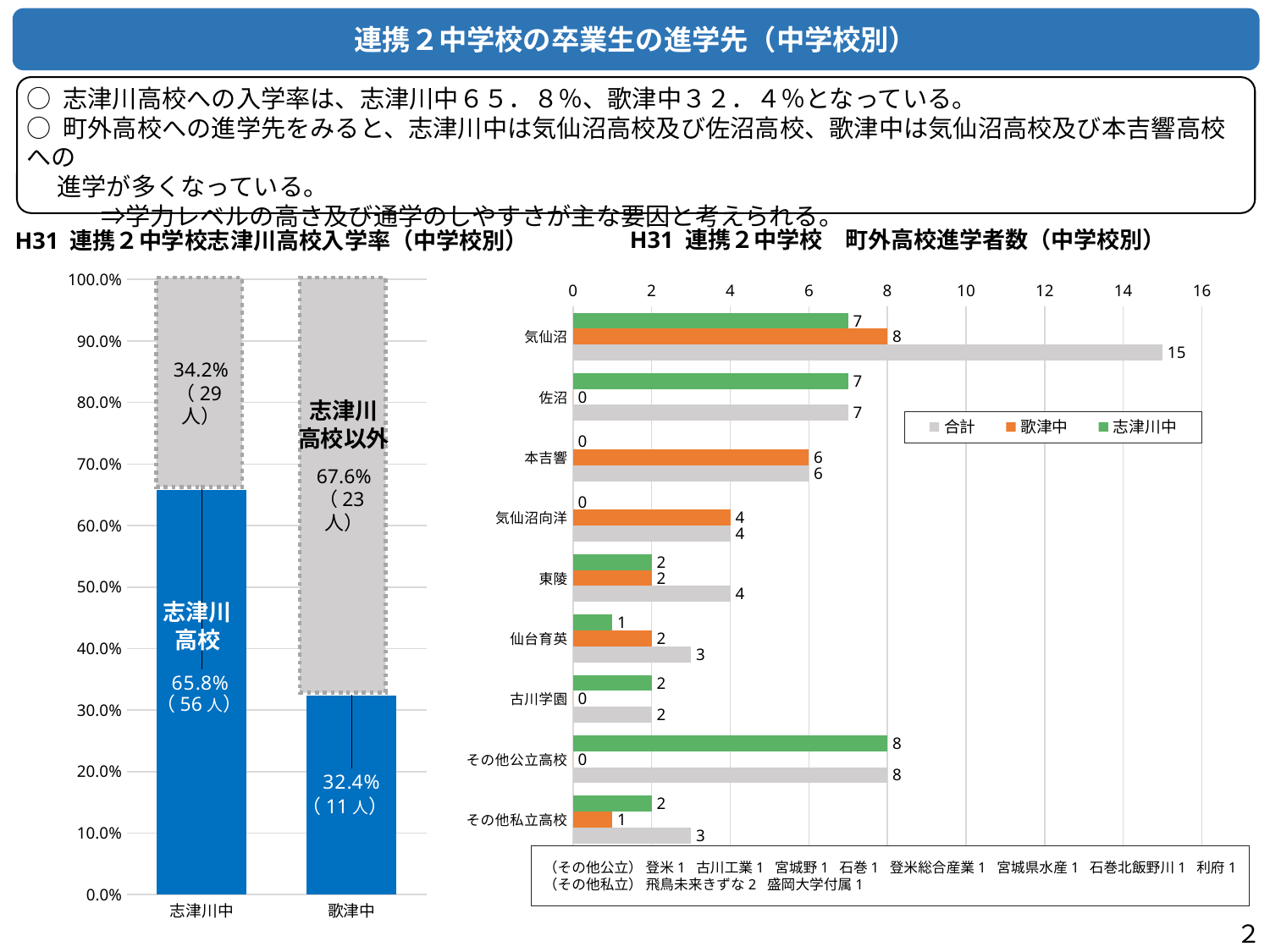
In the left chart (H31 連携２中学校志津川高校入学率), what is the 志津川高校 entry rate for 歌津中? 32.4% What kind of chart is the right chart (H31 連携２中学校 町外高校進学者数)? bar chart In the right chart (H31 連携２中学校 町外高校進学者数), how many students from 歌津中 went to 本吉響? 6 In the left chart (H31 連携２中学校志津川高校入学率), how many categories are shown on the x axis? 2 In the right chart (H31 連携２中学校 町外高校進学者数), how many destination categories are listed on the vertical axis? 9 In the right chart (H31 連携２中学校 町外高校進学者数), what is the 合計 value for 気仙沼? 15 In the right chart (H31 連携２中学校 町外高校進学者数), how many series does the legend list? 3 In the left chart (H31 連携２中学校志津川高校入学率), what is the 志津川高校 entry rate for 志津川中? 65.8% In the right chart (H31 連携２中学校 町外高校進学者数), which destination has the highest 合計 value? 気仙沼 In the left chart (H31 連携２中学校志津川高校入学率), what percentage of 歌津中 graduates went to schools other than 志津川高校 (志津川高校以外)? 67.6% In the left chart (H31 連携２中学校志津川高校入学率), which middle school has the higher 志津川高校 entry rate, 志津川中 or 歌津中? 志津川中 In the right chart (H31 連携２中学校 町外高校進学者数), what is the difference between the 志津川中 value and the 歌津中 value for 佐沼? 7